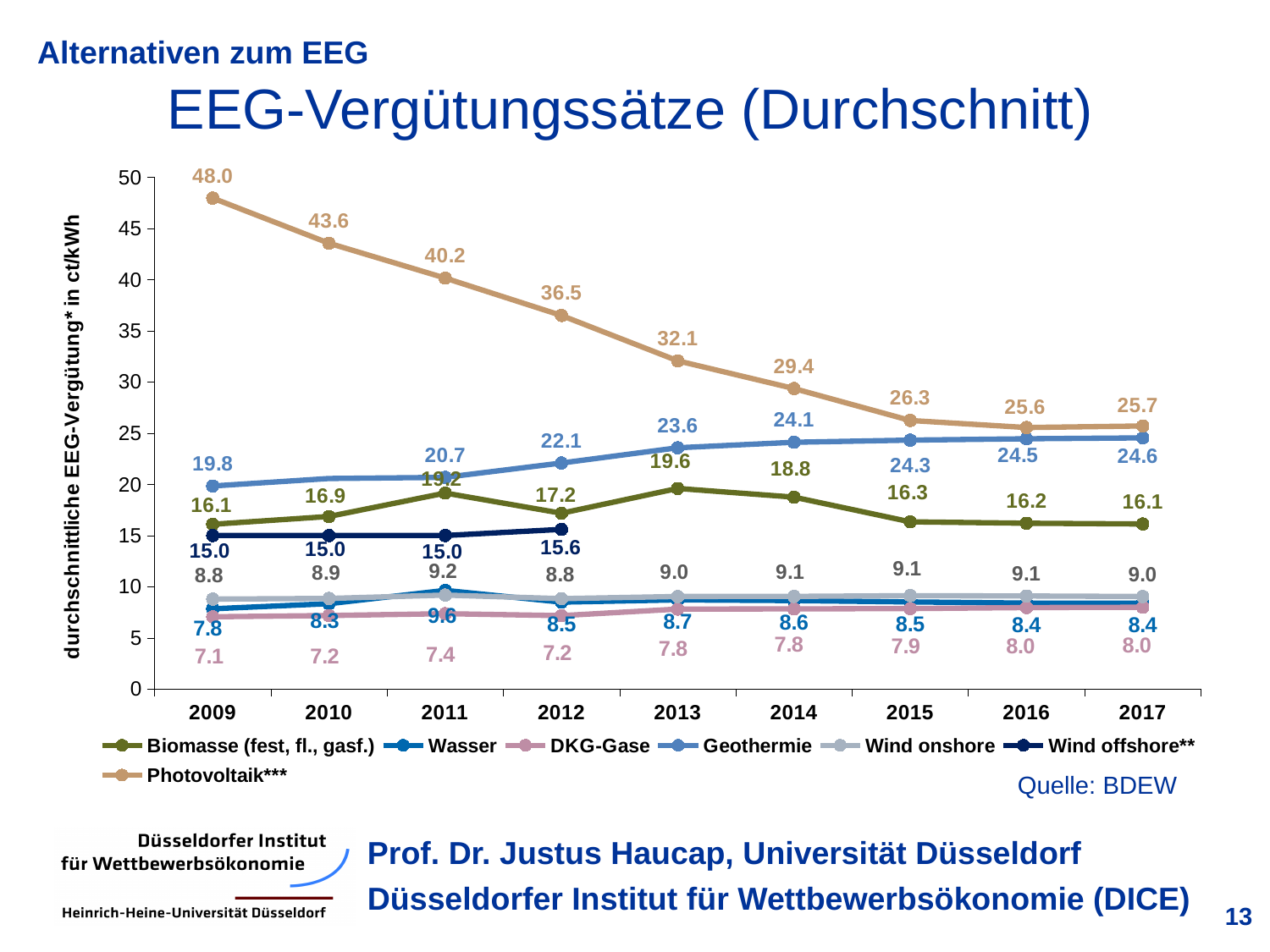
What is the value for Geothermie in 2013? 23.6 What is the value for Photovoltaik*** in 2009? 48.0 Is the value for Geothermie in 2010 greater or less than 25? less Which series has the highest value in 2009? Photovoltaik*** How many years are shown on the x axis? 9 What is the value for Photovoltaik*** in 2017? 25.7 Which series has the lowest value in 2009? DKG-Gase What is the value for Wind offshore** in 2012? 15.6 By how much did the Photovoltaik*** value fall from 2009 to 2017? 22.3 In 2017, which is larger: Geothermie or Biomasse (fest, fl., gasf.)? Geothermie Does the Photovoltaik*** series rise or fall from 2009 to 2015? fall How many series does the legend list? 7